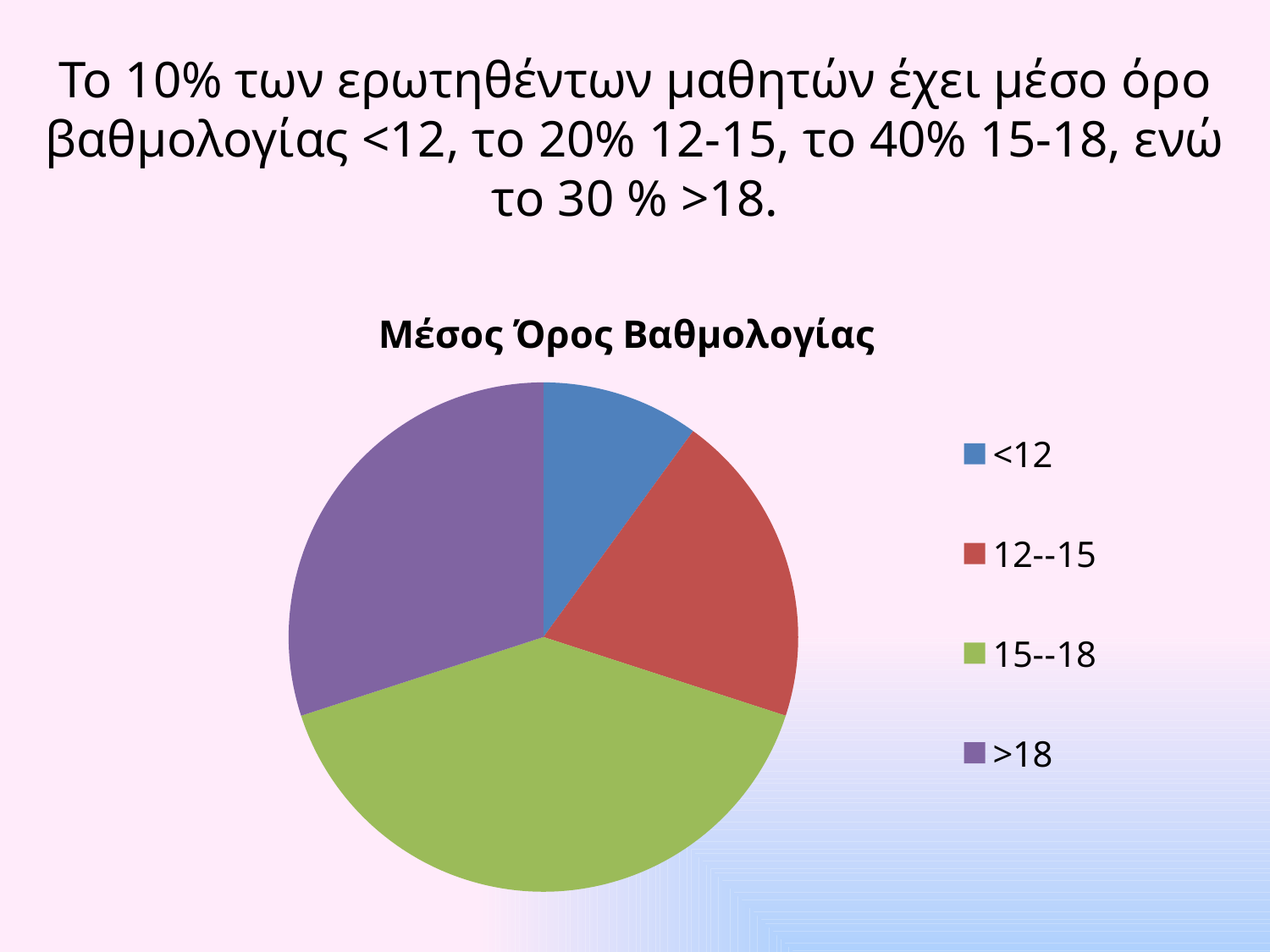
Which slice is larger, 15--18 or >18? 15--18 Which category has the smallest slice of the pie? <12 What share of the pie does the 15--18 category represent? 40% What kind of chart is shown on the slide? pie chart Which slice is larger, >18 or 12--15? >18 What share of the pie does the >18 category represent? 30% How many categories does the pie chart have? 4 What share of the pie does the <12 category represent? 10% Which category has the largest slice of the pie? 15--18 Which slice is larger, <12 or 12--15? 12--15 What colour is the 15--18 slice in the pie chart? green What is the title of the chart? Μέσος Όρος Βαθμολογίας